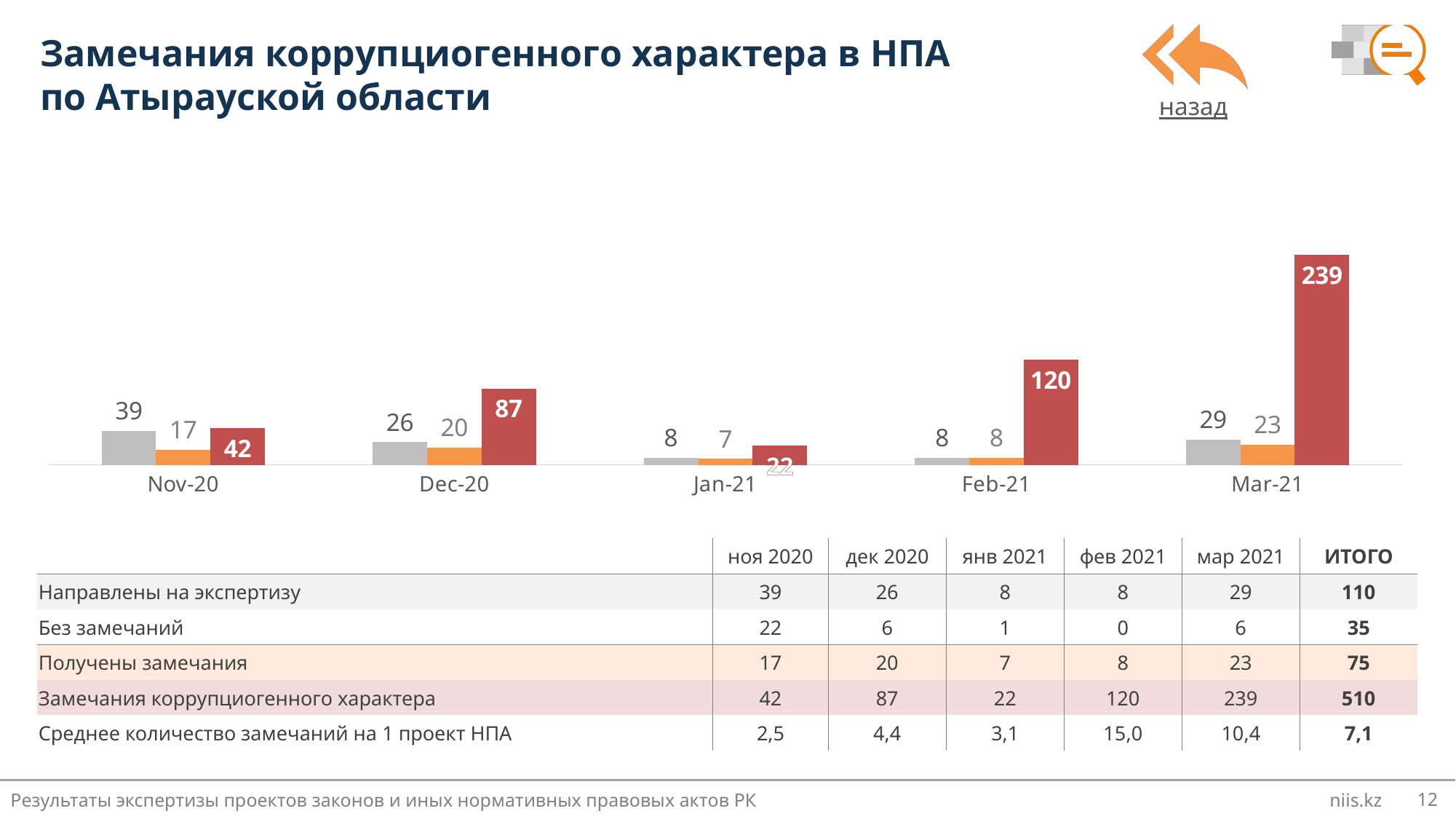
How many bars are shown for each month in the chart? 3 What is the value of the orange bar for Dec-20? 20 In which month is the red bar the highest? Mar-21 What is the value of the red bar for Mar-21? 239 Which is larger, the red bar for Dec-20 or the red bar for Nov-20? Dec-20 What is the value of the red bar for Feb-21? 120 What is the difference between the red bar values for Mar-21 and Feb-21? 119 How many months are shown on the x axis of the chart? 5 What is the difference between the gray bar and the orange bar for Nov-20? 22 What type of chart is shown on the slide? Bar chart In which month is the gray bar the lowest? Jan-21 and Feb-21 (both 8) What is the value of the gray bar for Nov-20? 39